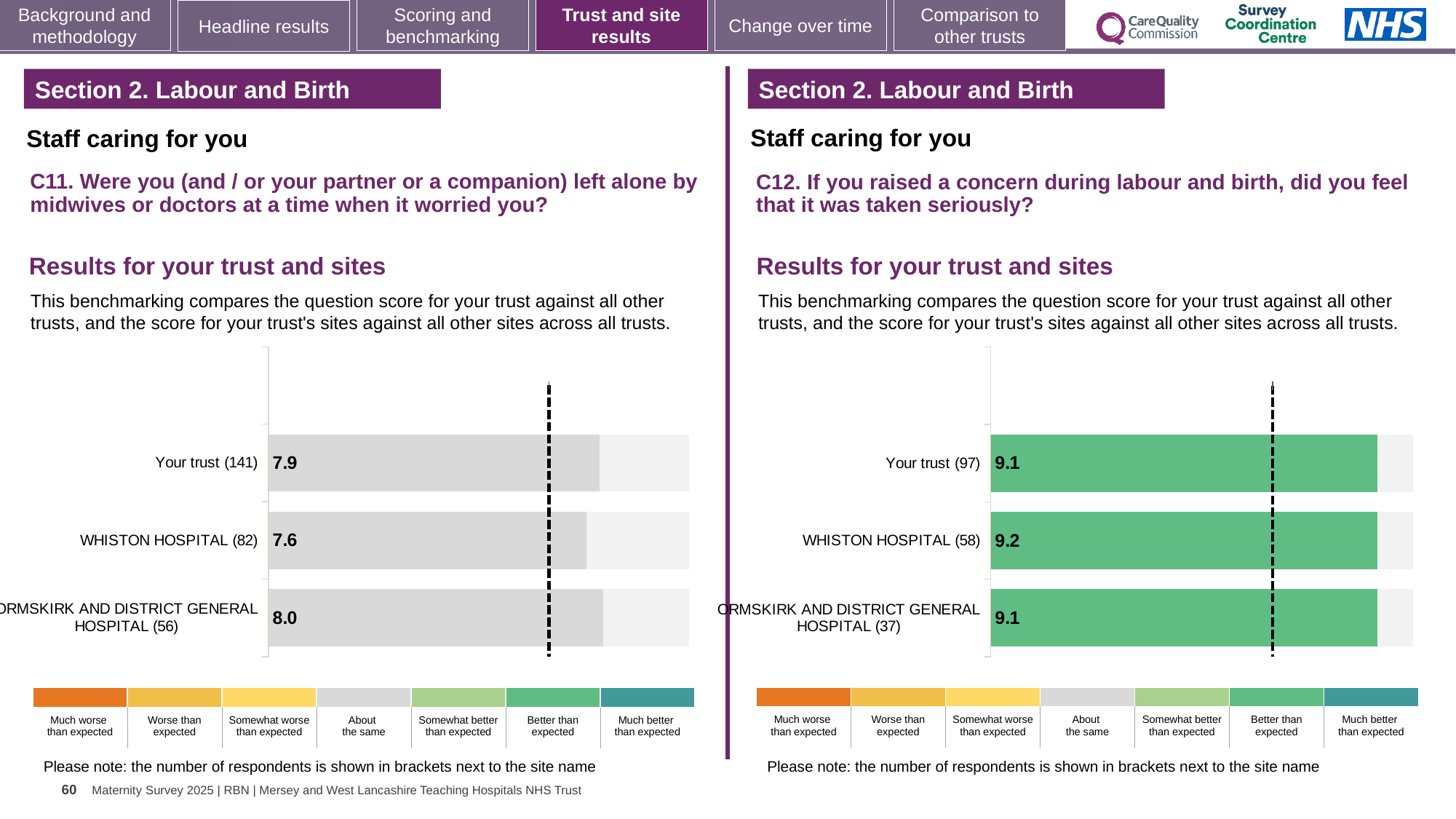
In the C12 chart on the right, how many bars are plotted? 3 Which is larger: the Your trust score in the C11 chart on the left or the Your trust score in the C12 chart on the right? C12 (9.1) In the C12 chart on the right, what is the score for Your trust (97)? 9.1 In the C11 chart on the left, which site or trust has the lowest score? WHISTON HOSPITAL (82) In the C12 chart on the right, what is the score for WHISTON HOSPITAL (58)? 9.2 In the C12 chart on the right, which benchmark category does the bar colour for Your trust (97) correspond to according to the legend? Better than expected In the C11 chart on the left, what is the score for ORMSKIRK AND DISTRICT GENERAL HOSPITAL (56)? 8.0 In the C11 chart on the left, what is the score for WHISTON HOSPITAL (82)? 7.6 In the C11 chart on the left, what is the score for Your trust (141)? 7.9 What type of chart is used in the C11 chart on the left? Bar chart In the C12 chart on the right, what is the score for ORMSKIRK AND DISTRICT GENERAL HOSPITAL (37)? 9.1 In the C11 chart on the left, what is the difference between the scores for ORMSKIRK AND DISTRICT GENERAL HOSPITAL (56) and WHISTON HOSPITAL (82)? 0.4